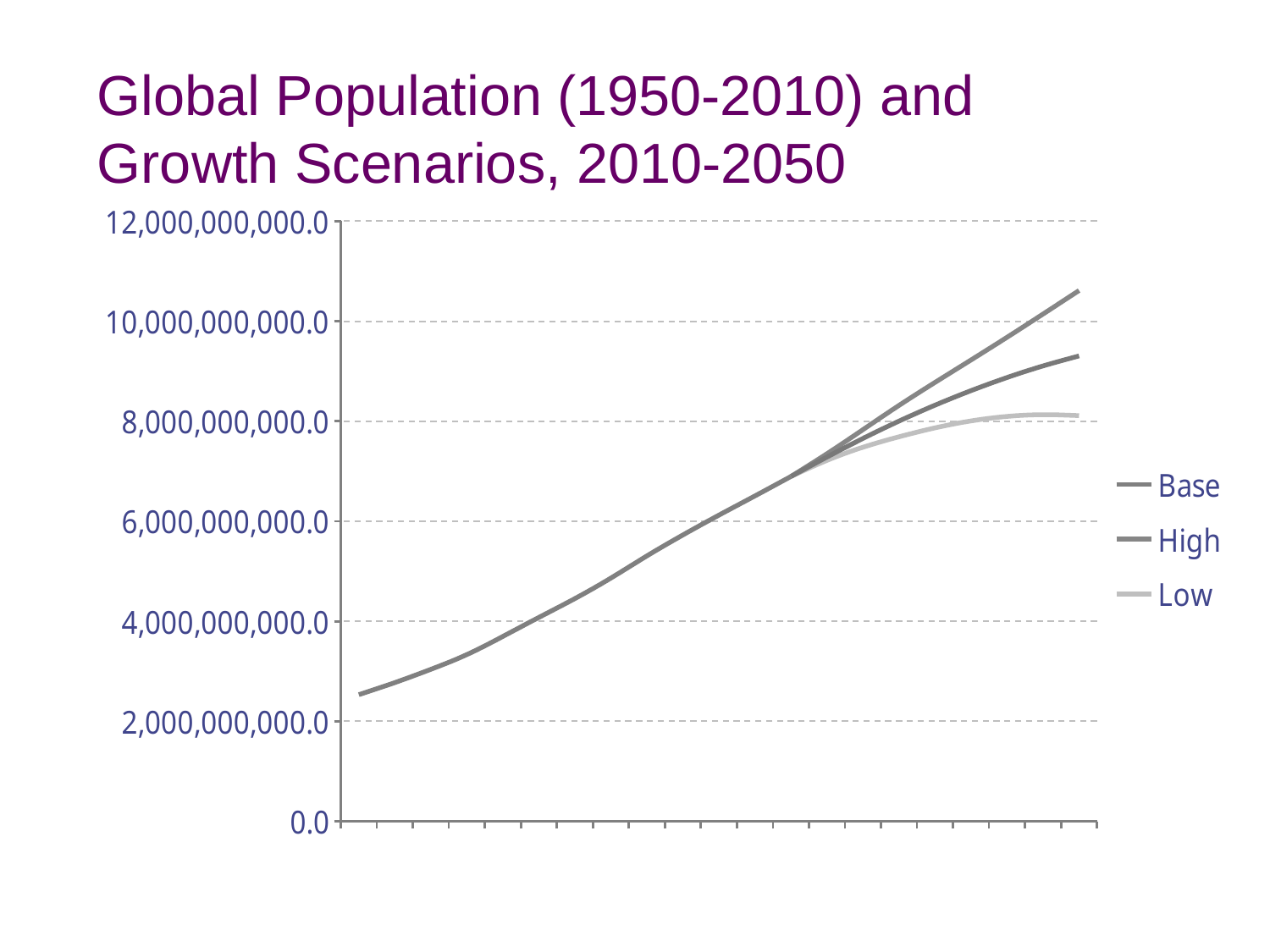
What kind of chart is shown on the slide? line chart Is the starting value at the left end of the lines greater or less than 4,000,000,000.0? less Which series has the lowest value at the right end of the chart? Low Is the final value of the High series greater or less than 10,000,000,000.0? greater Which series reaches the highest value at the right end of the chart? High How many series does the legend list? 3 Does the High series rise or fall along the x axis? rise At the right end of the chart, is the High series or the Low series larger? High What is the title of the chart on the slide? Global Population (1950-2010) and Growth Scenarios, 2010-2050 Is the final value of the Low series greater or less than 10,000,000,000.0? less What are the three series named in the legend? Base, High, Low